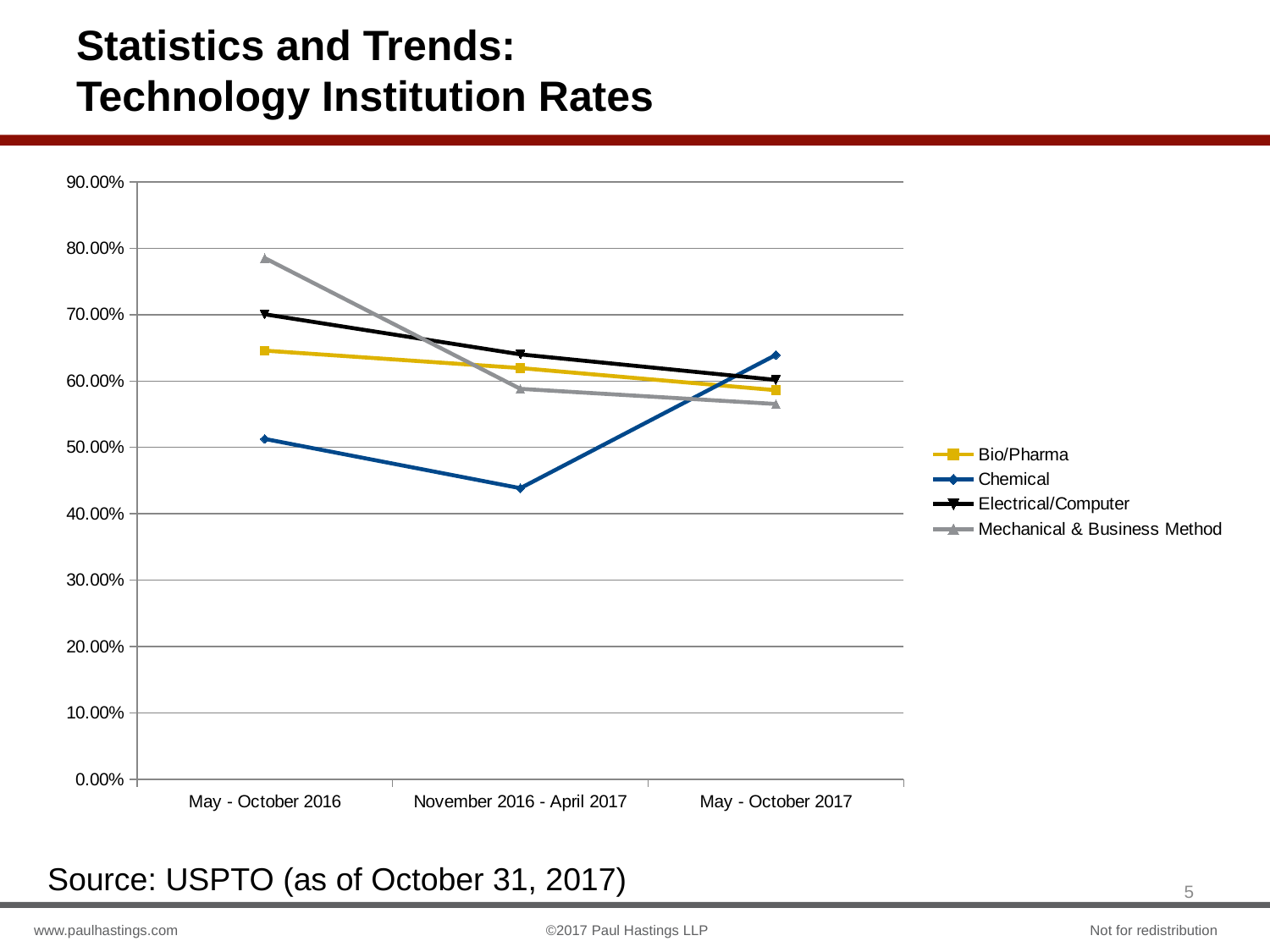
Which technology category has the lowest institution rate in May - October 2016? Chemical Does the Chemical institution rate rise or fall from November 2016 - April 2017 to May - October 2017? rise How many time periods are shown on the x axis? 3 Which technology category has the highest institution rate in May - October 2016? Mechanical & Business Method Which technology category has the lowest institution rate in November 2016 - April 2017? Chemical Is the Mechanical & Business Method institution rate for May - October 2016 greater or less than 70.00%? greater Which technology category has the highest institution rate in May - October 2017? Chemical In May - October 2016, which is larger: the Electrical/Computer rate or the Bio/Pharma rate? Electrical/Computer What kind of chart is shown on the slide? Line chart How many series does the legend list? 4 Does the Electrical/Computer institution rate rise or fall across the three periods from May - October 2016 to May - October 2017? fall Is the Chemical institution rate for November 2016 - April 2017 greater or less than 50.00%? less